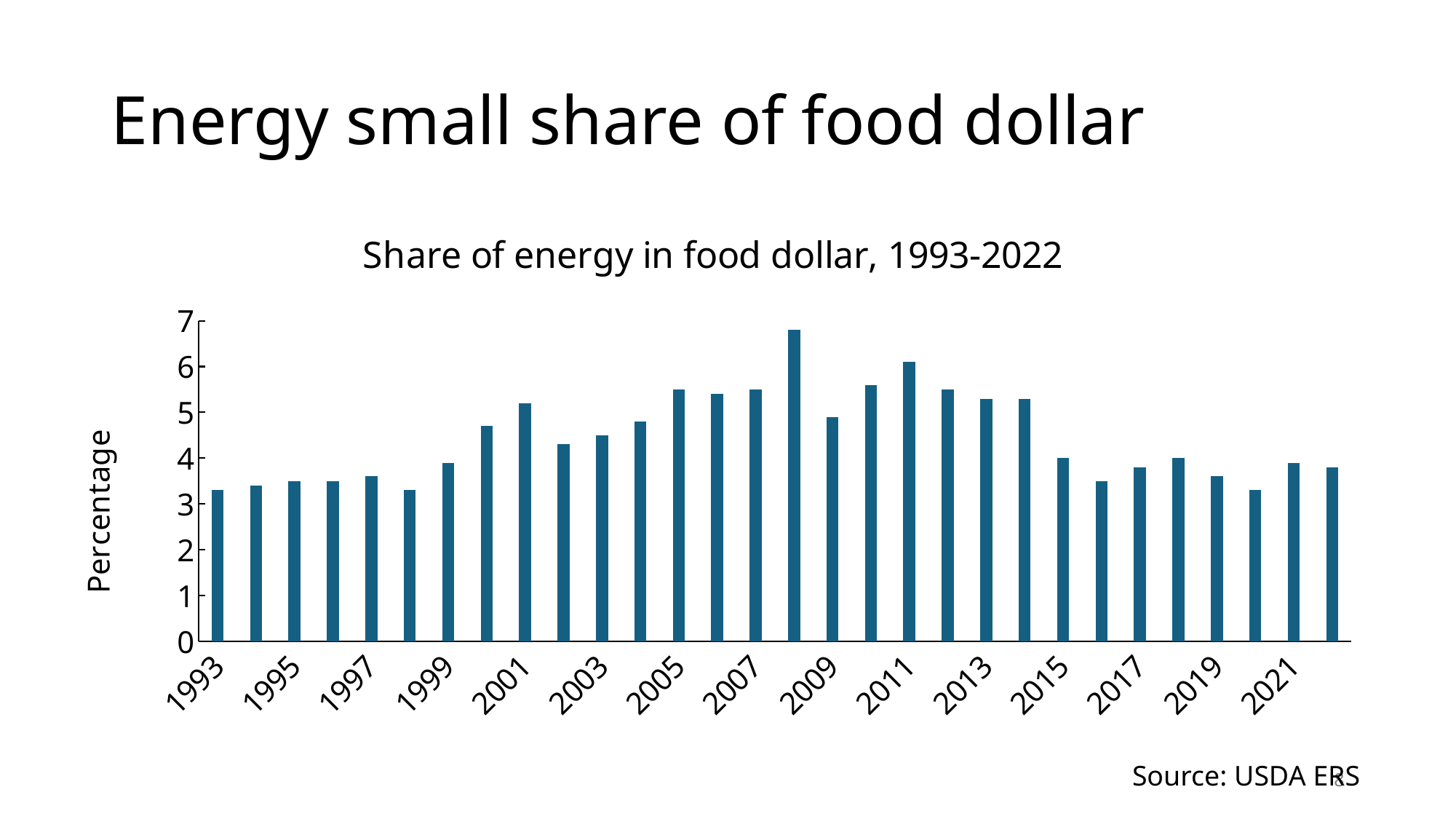
Is the value for 2005 greater or less than 5? greater Which year has the larger value, 2008 or 2011? 2008 Is the value for 1993 greater or less than 4? less What kind of chart is shown on the slide? Bar chart Is the value for 2020 greater or less than 4? less How many bars (years) are plotted in the chart? 30 Do the values rise or fall from 2012 to 2016? fall Which year has the highest share of energy in the food dollar? 2008 Which year has the larger value, 2001 or 1993? 2001 What is the label on the vertical axis of the chart? Percentage